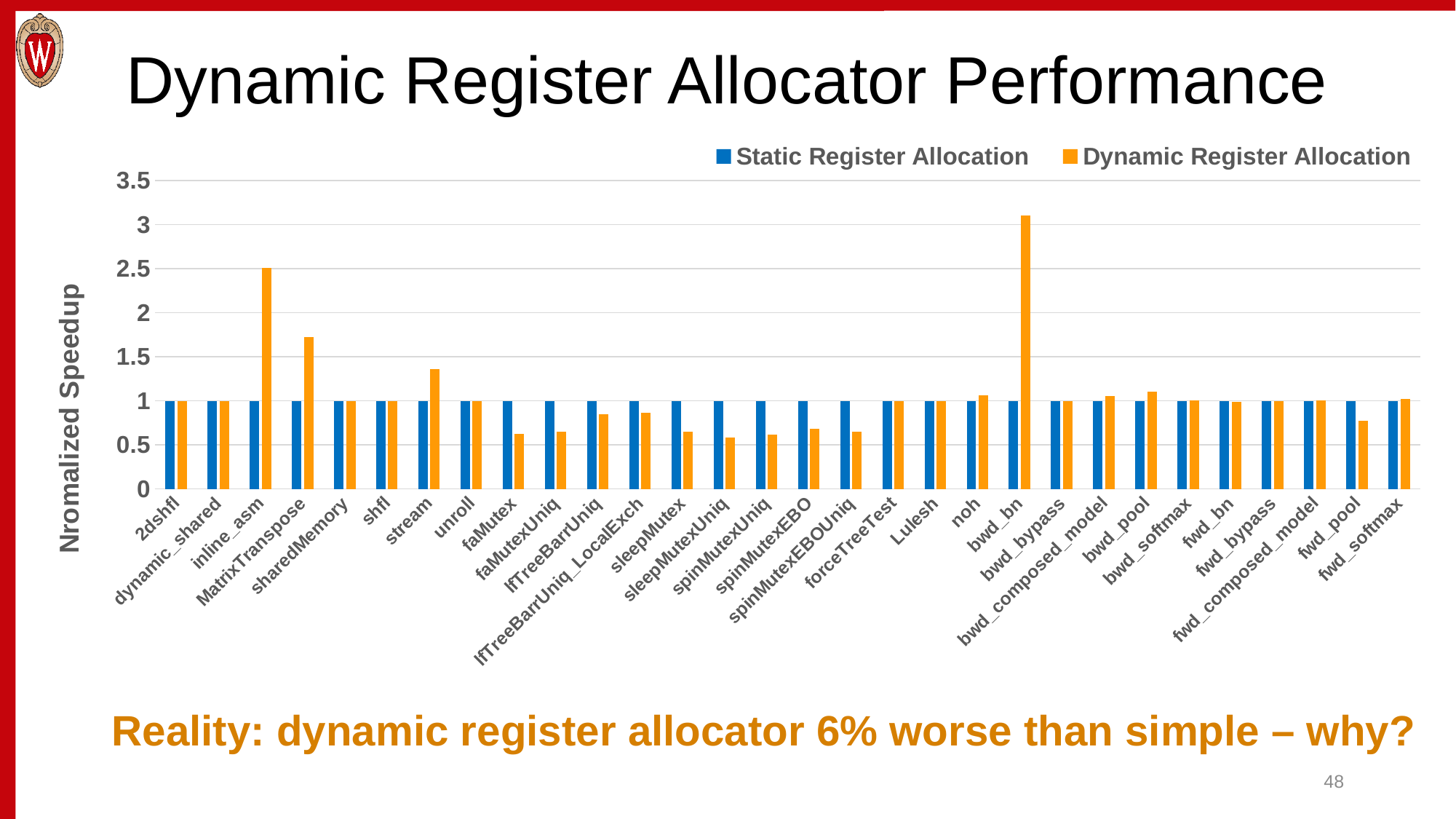
Is the Dynamic Register Allocation value for bwd_bn greater or less than 3? greater Is the Dynamic Register Allocation value for inline_asm greater or less than 2? greater Which is larger for sleepMutexUniq: the Static Register Allocation value or the Dynamic Register Allocation value? Static Register Allocation Is the Dynamic Register Allocation value for MatrixTranspose greater or less than 1.5? greater Which category has the highest Dynamic Register Allocation value? bwd_bn How many series does the legend list? 2 What kind of chart is shown on the slide? bar chart What is the label on the y axis of the chart? Nromalized Speedup How many benchmark categories are plotted along the x axis? 30 Which is larger for stream: the Static Register Allocation value or the Dynamic Register Allocation value? Dynamic Register Allocation What is the Static Register Allocation value for 2dshfl? 1